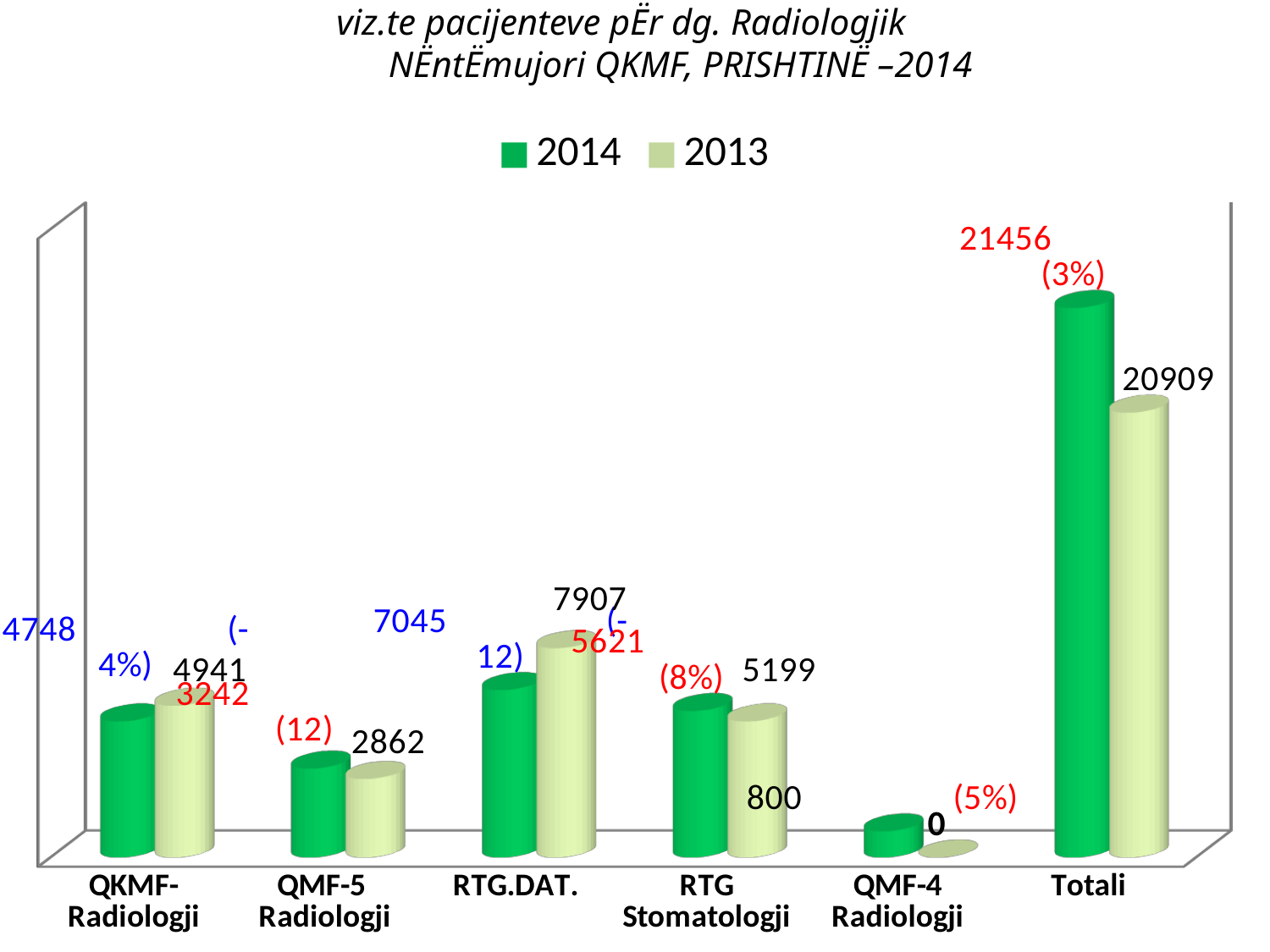
What is the 2013 value for Totali? 20909 How many categories are shown on the x axis? 6 What kind of chart is shown on the slide? bar chart Which category has the lowest 2013 value? QMF-4 Radiologji What is the 2014 value for Totali? 21456 How many series does the legend list? 2 What is the 2013 value for RTG.DAT.? 7907 Which category has the highest 2014 value? Totali Which series is shown in dark green in the legend? 2014 What is the difference between the 2014 and 2013 values for Totali? 547 What is the 2013 value for QMF-4 Radiologji? 0 What is the 2014 value for QMF-4 Radiologji? 800